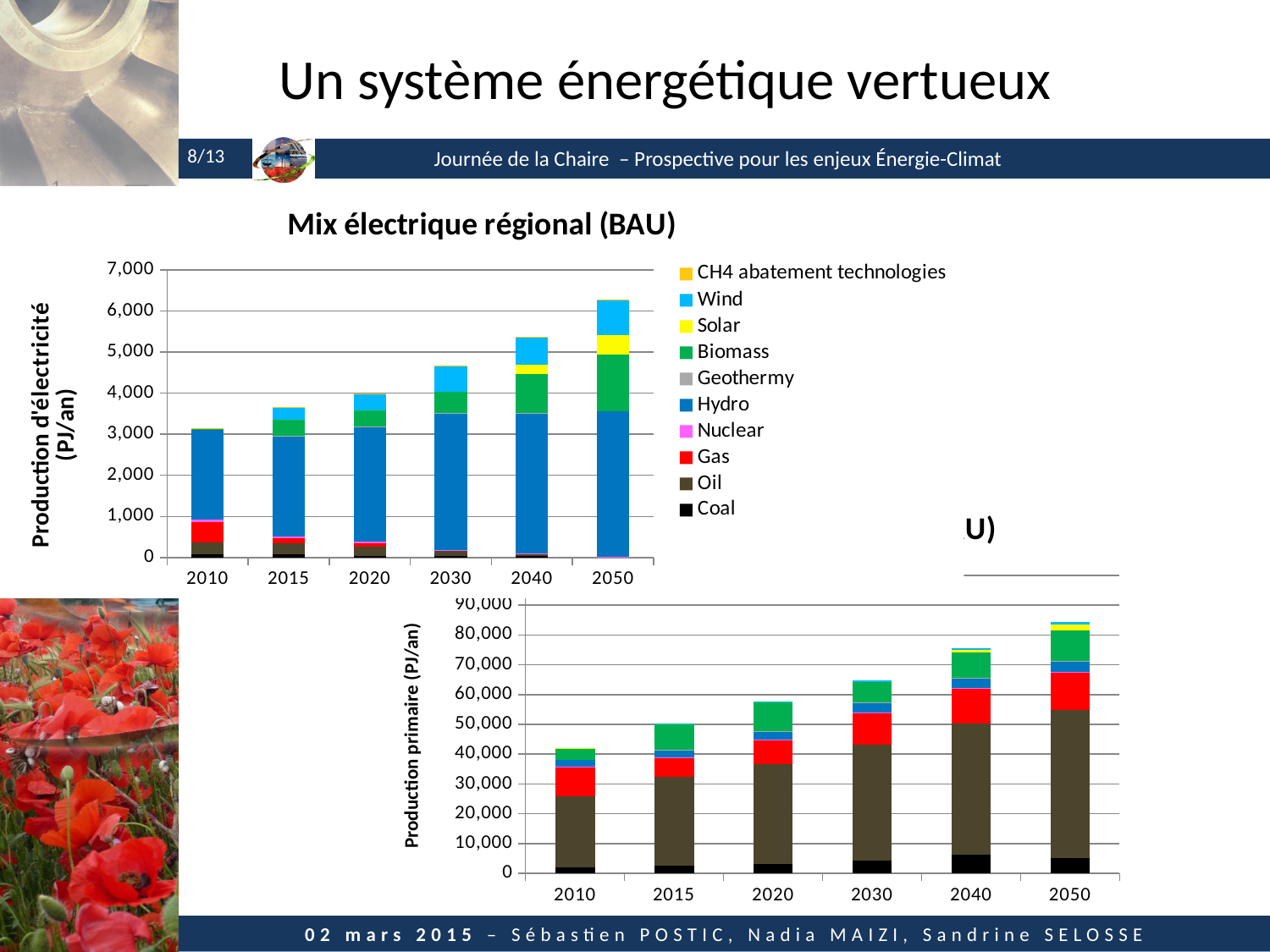
In the 'Mix électrique régional (BAU)' chart, which year has the lowest total electricity production? 2010 What kind of chart is the 'Mix électrique régional (BAU)' chart at the top of the slide? Stacked bar chart In the 'Mix électrique régional (BAU)' chart, is the total bar for 2050 greater or less than 6,000? greater In the 'Mix électrique régional (BAU)' chart, is the total bar for 2020 greater or less than 5,000? less How many series does the legend of the 'Mix électrique régional (BAU)' chart list? 10 In the 'Mix électrique régional (BAU)' chart, do the total bar heights rise or fall from 2010 to 2050? Rise In the 'Mix électrique régional (BAU)' chart, which year has the highest total electricity production? 2050 In the bottom chart (Production primaire), is the total bar for 2050 greater or less than 80,000? greater In the bottom chart (Production primaire), which year has the highest total bar? 2050 How many years are shown on the x axis of the 'Mix électrique régional (BAU)' chart? 6 What is the y-axis label of the 'Mix électrique régional (BAU)' chart? Production d'électricité (PJ/an)